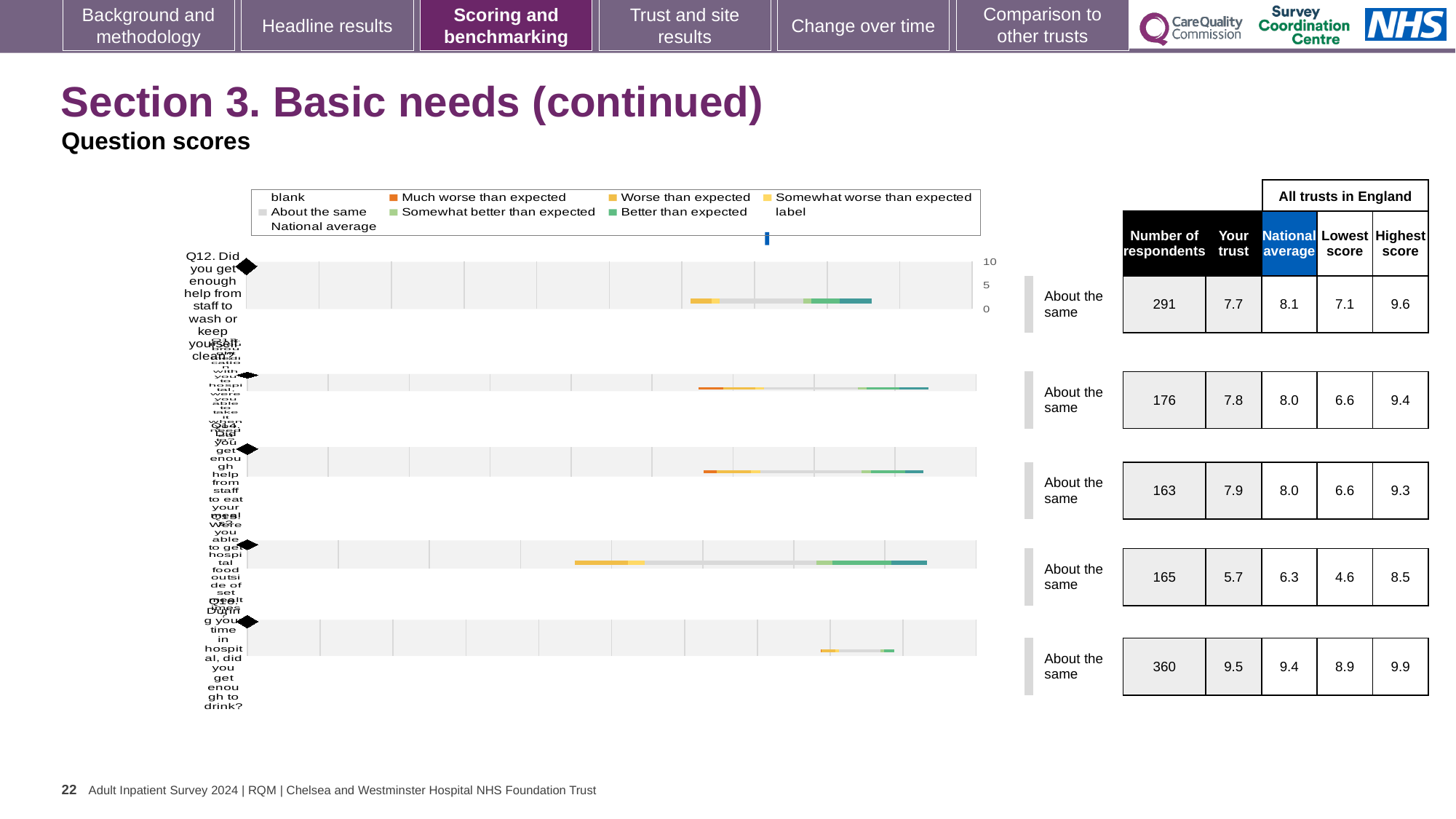
What benchmark category is shown next to every row of the chart? About the same How many question rows are plotted in the chart? 5 What is the national average for the fourth row of the chart? 6.3 Which row has the lowest 'Your trust' score? the fourth row, 5.7 What is the lowest score among all trusts in England for the fourth row? 4.6 Which row has the highest 'Your trust' score? the bottom (fifth) row, 9.5 How many respondents answered Q12 (the top row)? 291 What is the highest score among all trusts in England for the second row? 9.4 For Q12 (the top row), what is the difference between the national average and the trust's score? 0.4 For the bottom row, is the trust's score higher or lower than the national average? higher What kind of chart is used to show the question scores on this slide? bar chart What is the 'Your trust' score for Q12 (the top row, about getting enough help from staff to wash or keep yourself clean)? 7.7